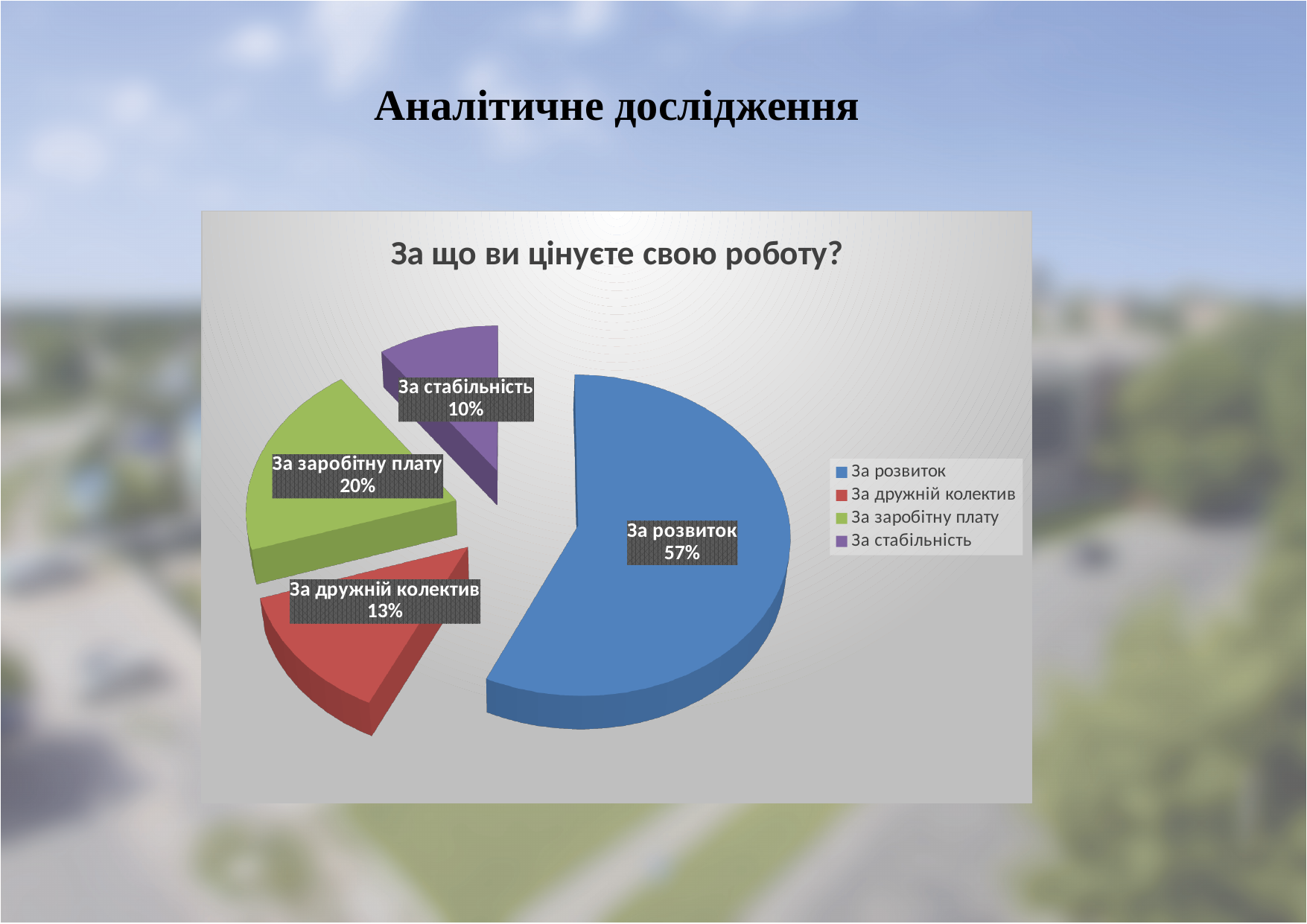
What percentage of the pie is labelled "За розвиток"? 57% Which category has the smallest share of the pie? За стабільність What is the title of the chart? За що ви цінуєте свою роботу? Which category has the largest share of the pie? За розвиток What percentage of the pie is labelled "За заробітну плату"? 20% What percentage of the pie is labelled "За стабільність"? 10% What kind of chart is shown on the slide? Pie chart What percentage of the pie is labelled "За дружній колектив"? 13% How many entries does the legend list? 4 How many slices does the pie chart have? 4 What is the difference in percentage points between "За заробітну плату" and "За дружній колектив"? 7 Which is larger, the share for "За дружній колектив" or the share for "За стабільність"? За дружній колектив